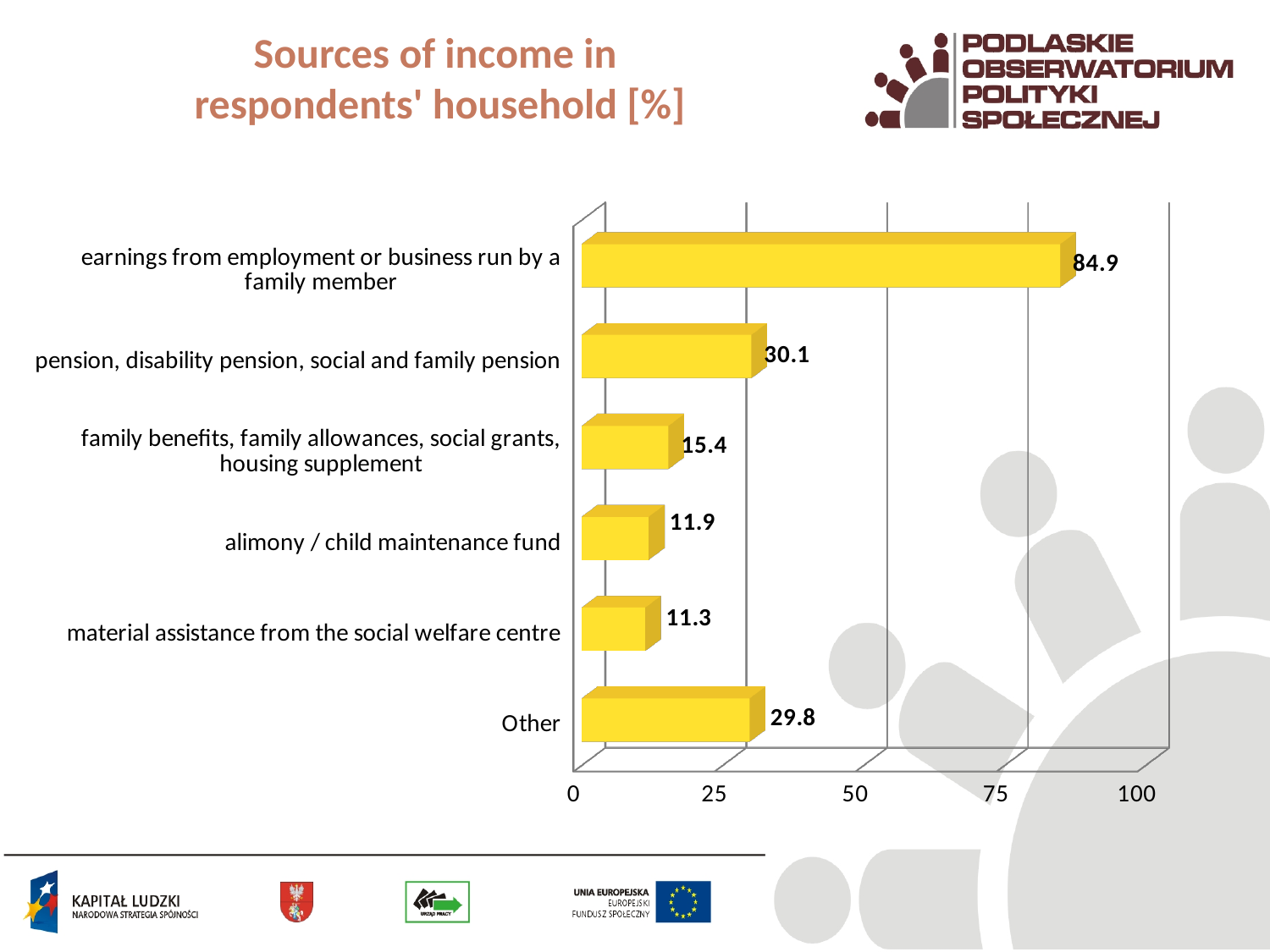
What kind of chart is shown on the slide? bar chart Which source of income has the highest value? earnings from employment or business run by a family member What is the difference between the values for 'earnings from employment or business run by a family member' and 'pension, disability pension, social and family pension'? 54.8 What is the difference between the values for 'family benefits, family allowances, social grants, housing supplement' and 'material assistance from the social welfare centre'? 4.1 How many sources of income are shown in the chart? 6 What is the value for 'Other'? 29.8 What is the value for 'alimony / child maintenance fund'? 11.9 Is the value for 'earnings from employment or business run by a family member' greater or less than 75? greater What is the value for 'pension, disability pension, social and family pension'? 30.1 What is the value for 'earnings from employment or business run by a family member'? 84.9 Which is larger: the value for 'pension, disability pension, social and family pension' or the value for 'Other'? pension, disability pension, social and family pension Which source of income has the lowest value? material assistance from the social welfare centre